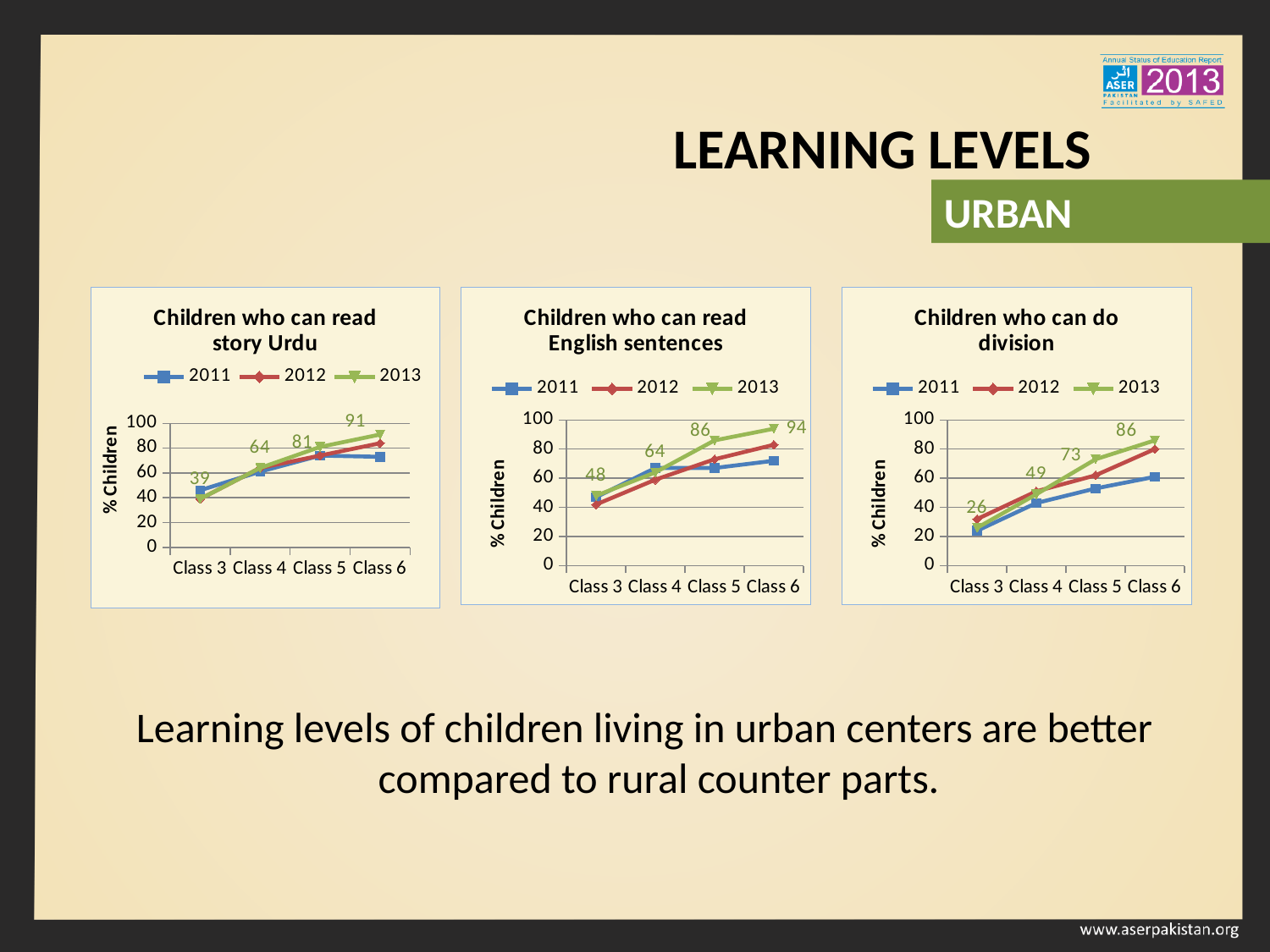
In the 'Children who can read English sentences' chart, what is the 2013 value for Class 3? 48 In the 'Children who can read story Urdu' chart, what is the difference between the 2013 values for Class 6 and Class 3? 52 In the 'Children who can do division' chart, which class has the highest 2013 value? Class 6 What kind of chart is the 'Children who can read English sentences' chart? Line chart In the 'Children who can do division' chart, what is the 2013 value for Class 5? 73 In the 'Children who can read English sentences' chart, which class has the lowest 2013 value? Class 3 How many series does the legend list in the 'Children who can read story Urdu' chart? 3 In the 'Children who can read English sentences' chart, is the 2013 value for Class 5 larger than the 2013 value for Class 4? Yes, Class 5 (86) is larger In the 'Children who can do division' chart, what is the difference between the 2013 values for Class 4 and Class 3? 23 In the 'Children who can read story Urdu' chart, what is the 2013 value for Class 6? 91 In the 'Children who can do division' chart, is the 2011 value for Class 6 greater or less than 80? less In the 'Children who can do division' chart, do the 2013 values rise or fall from Class 3 to Class 6? Rise